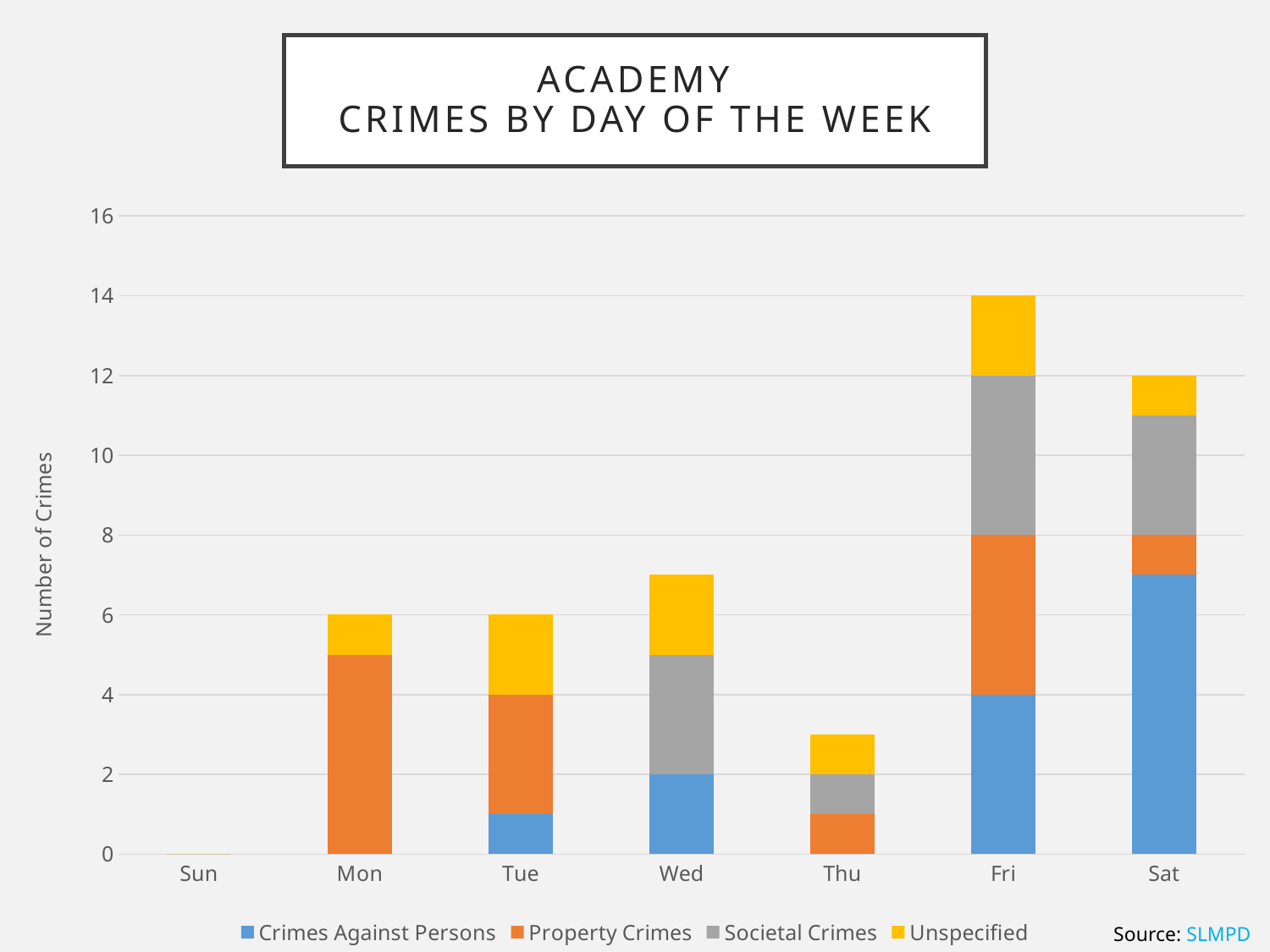
Is the total number of crimes on Wed greater or less than 6? greater What kind of chart is shown on the slide? Stacked bar chart Which colour represents Unspecified crimes in the legend? Yellow What is the total number of crimes on Mon? 6 What is the total number of crimes on Sat? 12 How many Crimes Against Persons are shown for Fri? 4 Which day has the lowest total number of crimes? Sun What is the difference between the total crimes on Fri and on Sat? 2 Which day has the highest total number of crimes? Fri How many days of the week are shown on the x axis? 7 How many series does the legend list? 4 What is the total number of crimes on Fri? 14